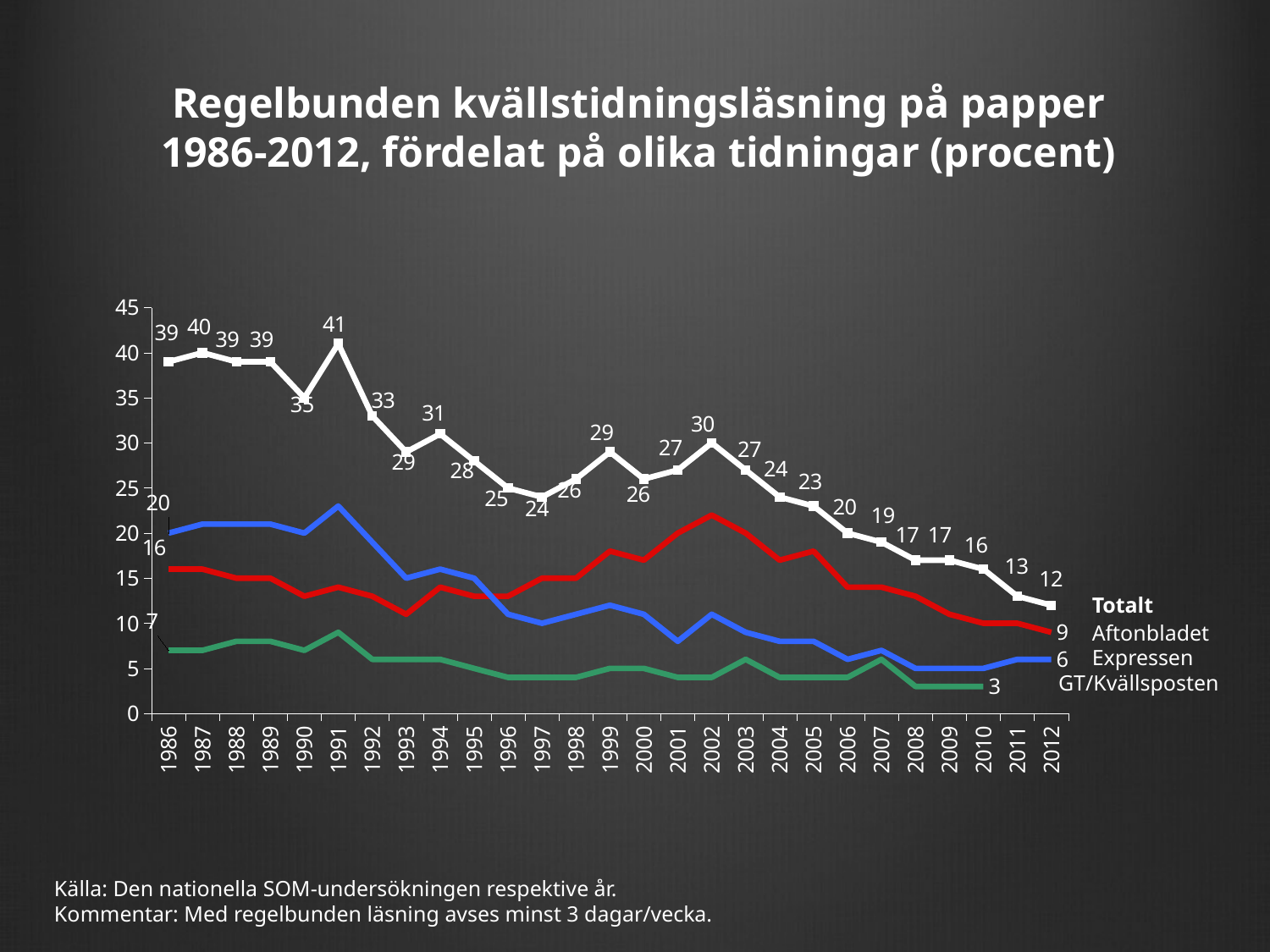
Is the value for Aftonbladet in 2002 greater or less than 20? greater Which year has a higher Totalt value, 2002 or 2003? 2002 What is the value of Aftonbladet in 2012? 9 How many years are shown on the x axis? 27 What is the difference between the Totalt value in 1986 and in 2012? 27 What is the value of Expressen in 1986? 20 How many series does the chart show? 4 In which year is the Totalt series at its lowest value? 2012 Does the Totalt series generally rise or fall from 1986 to 2012? fall What is the value of Totalt in 1991? 41 What kind of chart is shown on the slide? line chart In which year does the Totalt series reach its highest value? 1991